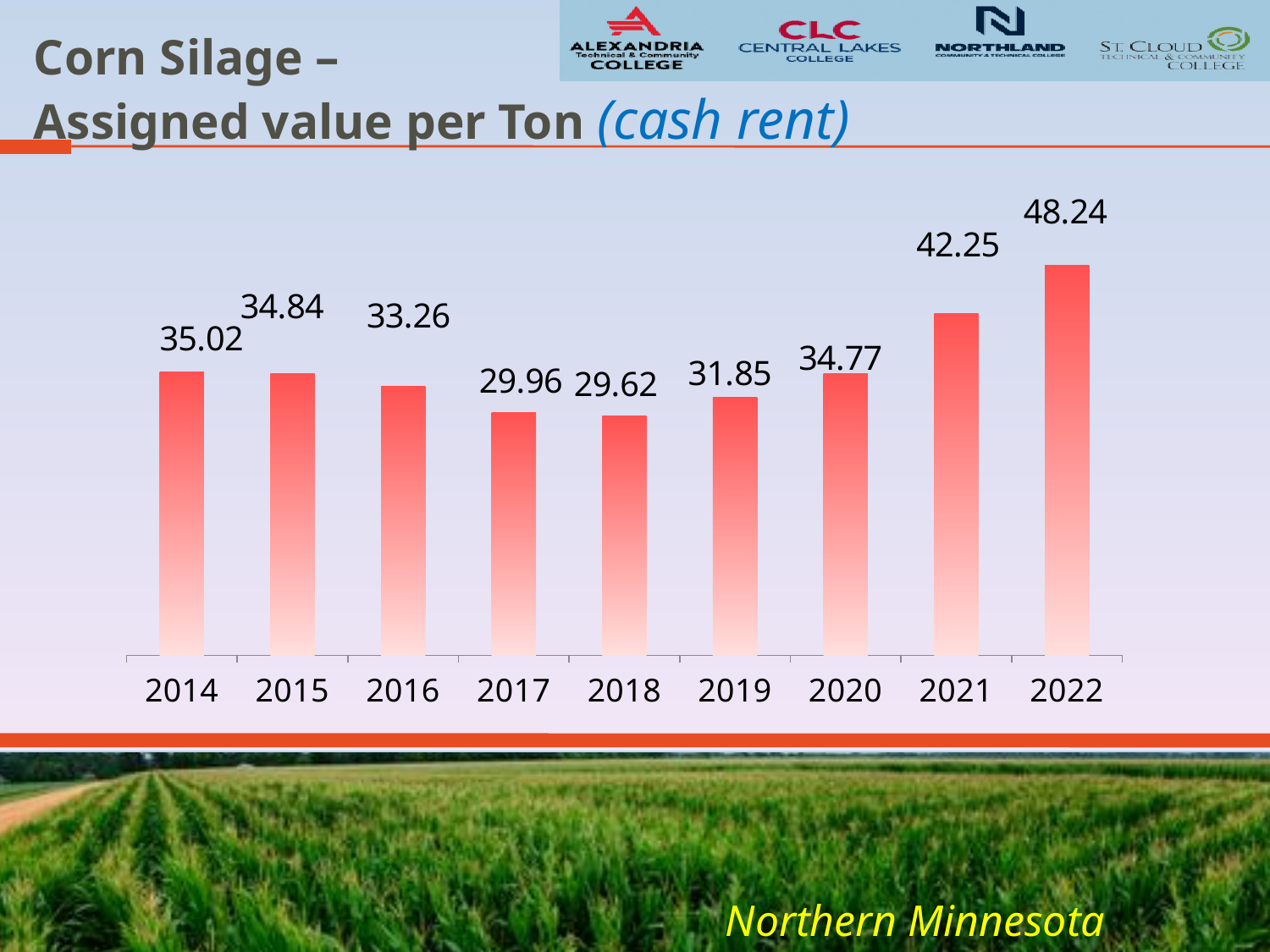
Which is larger, the value for 2019 or the value for 2017? 2019 Which year has the highest assigned value per ton? 2022 What kind of chart is shown on the slide? Bar chart What is the assigned value per ton for 2018? 29.62 What is the assigned value per ton for 2014? 35.02 What is the difference between the 2015 value and the 2014 value? -0.18 Do the values rise or fall from 2018 to 2022? Rise Which is larger, the value for 2016 or the value for 2020? 2020 How many years are shown on the chart? 9 Which year has the lowest assigned value per ton? 2018 What is the assigned value per ton for 2022? 48.24 What is the difference between the 2022 value and the 2021 value? 5.99